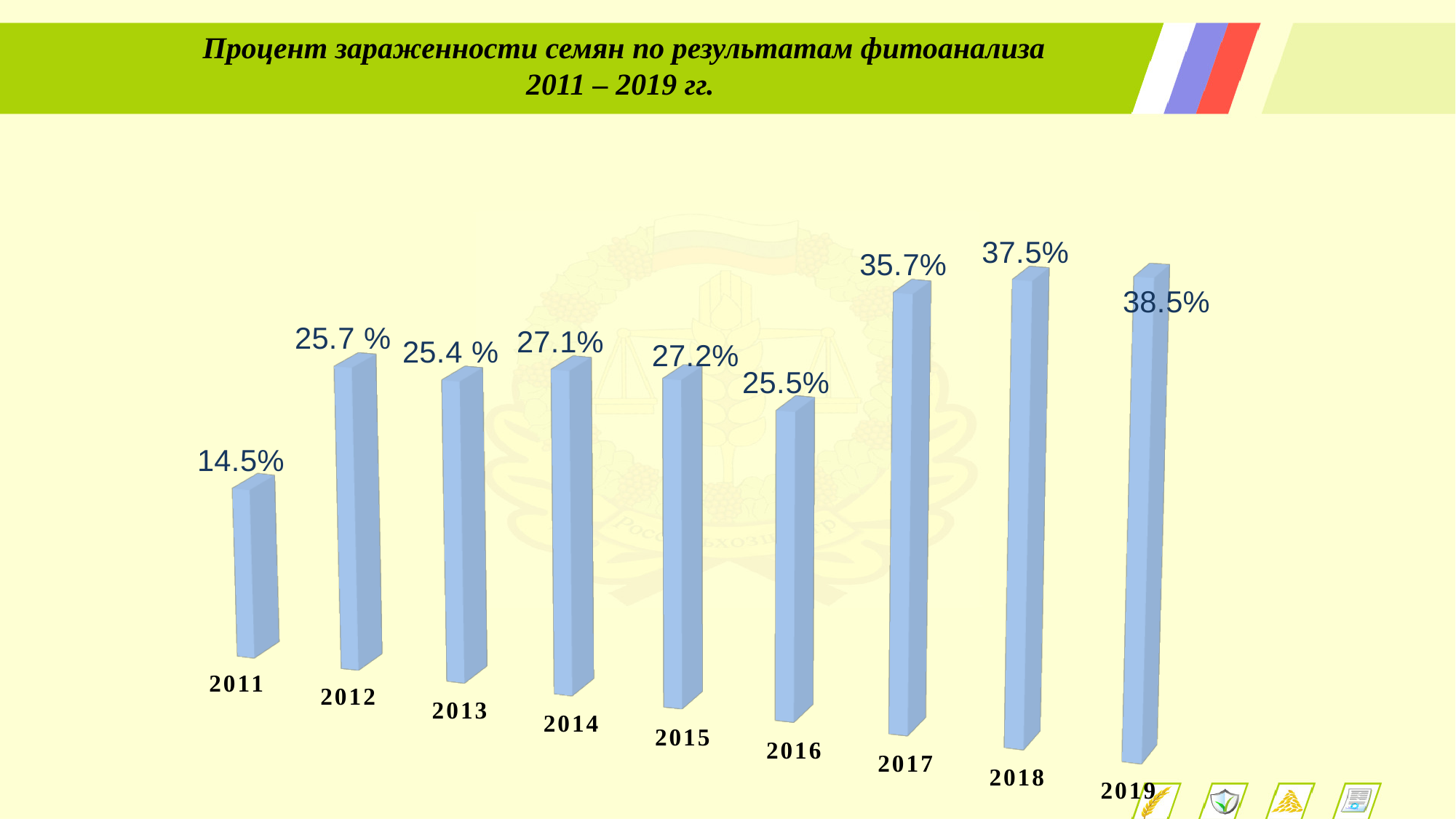
What is the difference between the values for 2019 and 2011? 24 percentage points What is the value for 2019? 38.5% Which year has the highest value? 2019 What is the value for 2011? 14.5% Do the values generally rise or fall from 2011 to 2019? Rise What kind of chart is shown on the slide? Bar chart What is the value for 2017? 35.7% Which is larger, the value for 2016 or the value for 2017? 2017 How many years are shown on the chart? 9 What is the value for 2016? 25.5% Which year has the lowest value? 2011 What is the difference between the values for 2018 and 2017? 1.8 percentage points